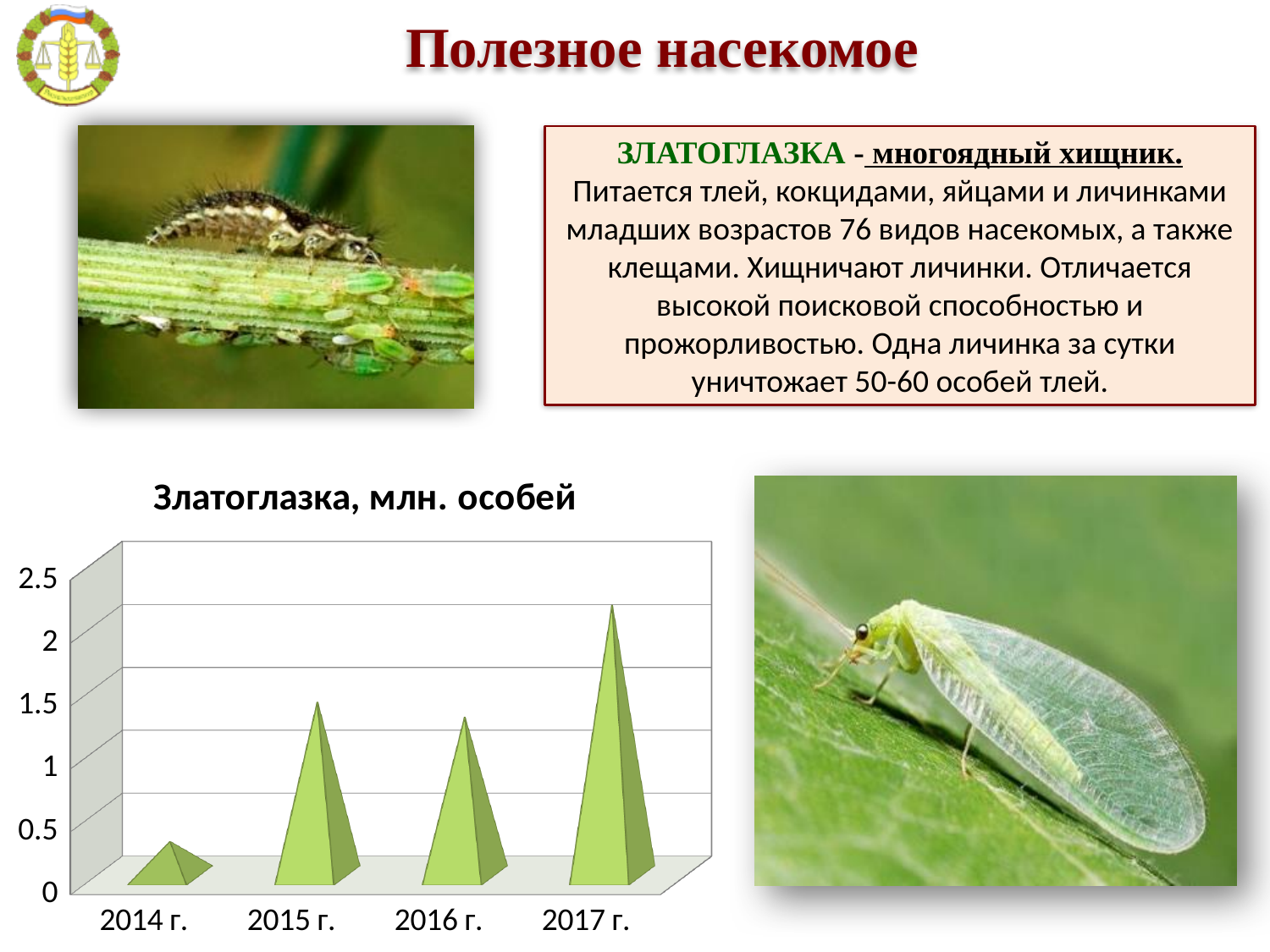
Which is larger, the value for 2017 г. or the value for 2015 г.? 2017 г. What kind of chart is shown under the title "Златоглазка, млн. особей"? bar chart How many years are shown on the x axis of the "Златоглазка, млн. особей" chart? 4 What is the title of the chart on the slide? Златоглазка, млн. особей Which year has the highest value in the "Златоглазка, млн. особей" chart? 2017 г. Which is larger, the value for 2014 г. or the value for 2016 г.? 2016 г. Which year has the lowest value in the "Златоглазка, млн. особей" chart? 2014 г. Is the value for 2016 г. greater or less than 1? greater Is the value for 2017 г. greater or less than 2? greater Is the value for 2014 г. greater or less than 0.5? less